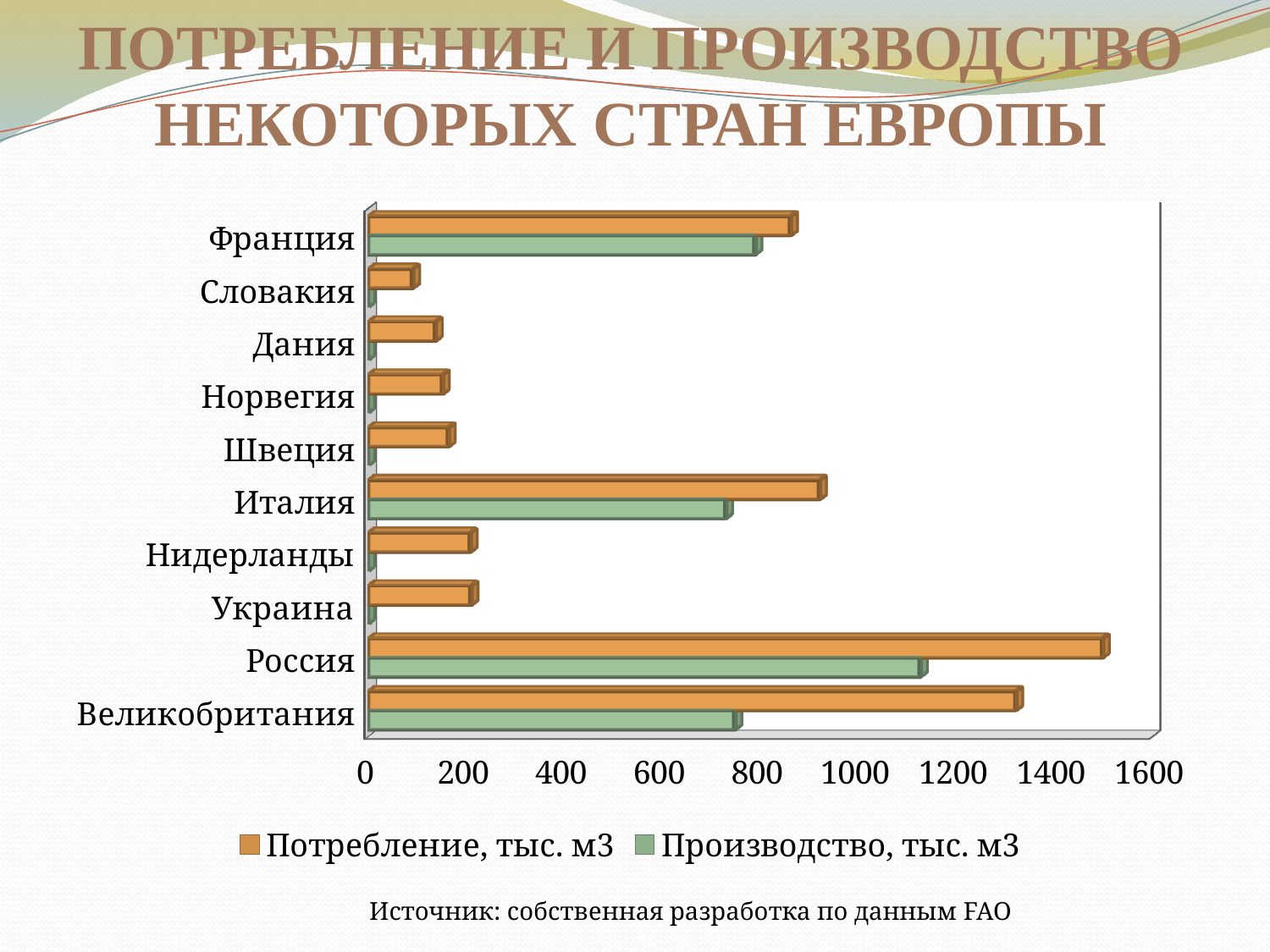
Is the Потребление value for Россия greater or less than 1400? greater How many countries are listed on the chart? 10 Which country has the lowest value for Потребление, тыс. м3? Словакия Is the Производство value for Италия greater or less than 800? less Which is larger for Великобритания: Потребление or Производство? Потребление Is the Производство value for Россия greater or less than 1000? greater What are the two series named in the legend? Потребление, тыс. м3 and Производство, тыс. м3 Which country has the larger Производство value: Франция or Италия? Франция How many series does the legend list? 2 What kind of chart is shown on the slide? bar chart Which country has the highest value for Потребление, тыс. м3? Россия